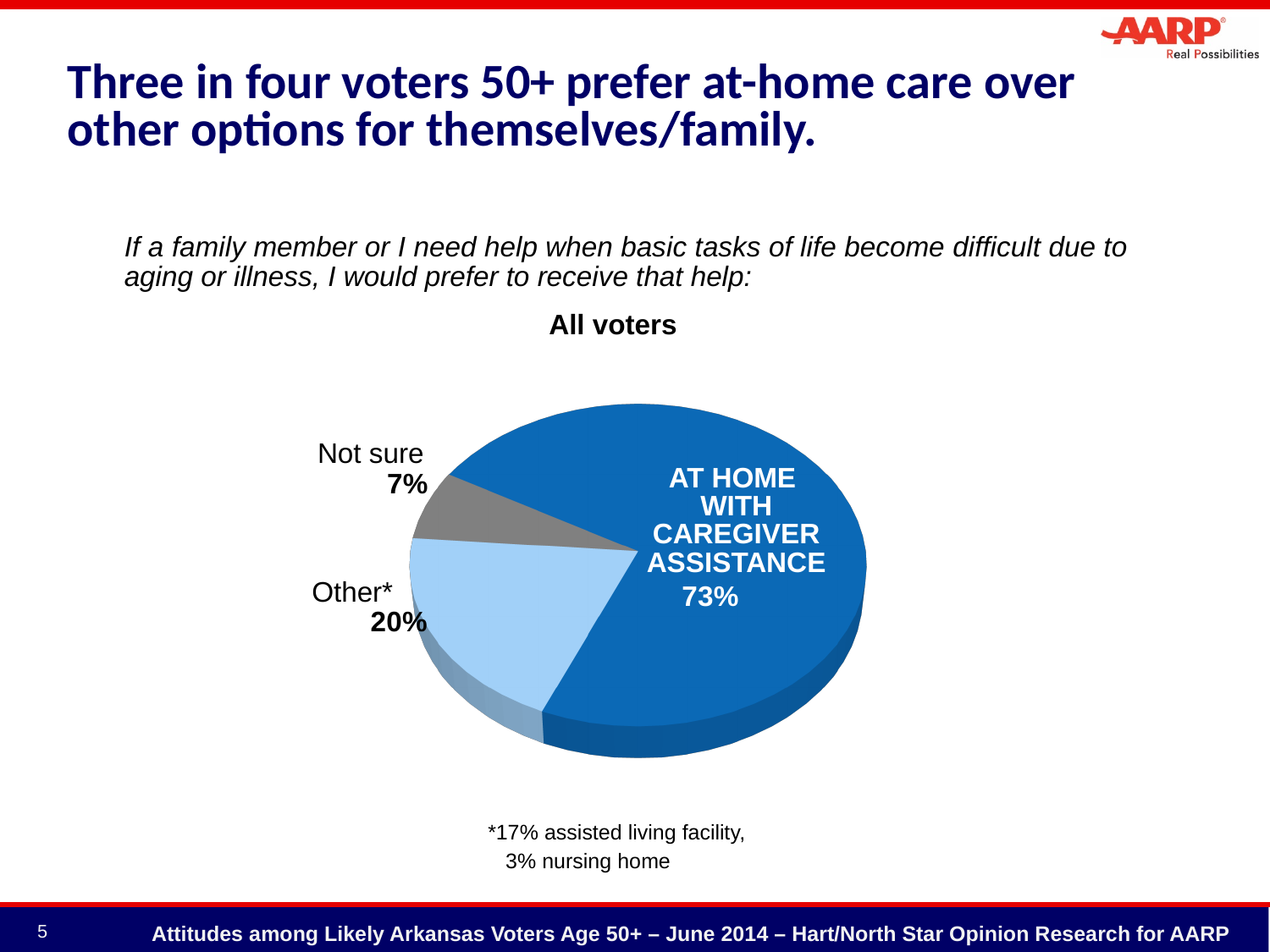
What percentage of voters chose Other*? 20% What kind of chart is shown on the slide? Pie chart According to the footnote, what percentage chose an assisted living facility? 17% What is the difference in percentage points between the at home with caregiver assistance slice and the Other* slice? 53 What percentage of voters are Not sure? 7% Which is larger, the Other* slice or the Not sure slice? Other* What is the difference in percentage points between Other* and Not sure? 13 How many slices does the pie chart have? 3 What is the title shown above the pie chart? All voters What share of all voters prefer at home with caregiver assistance? 73% Which slice of the pie is the smallest? Not sure Which slice of the pie is the largest? At home with caregiver assistance